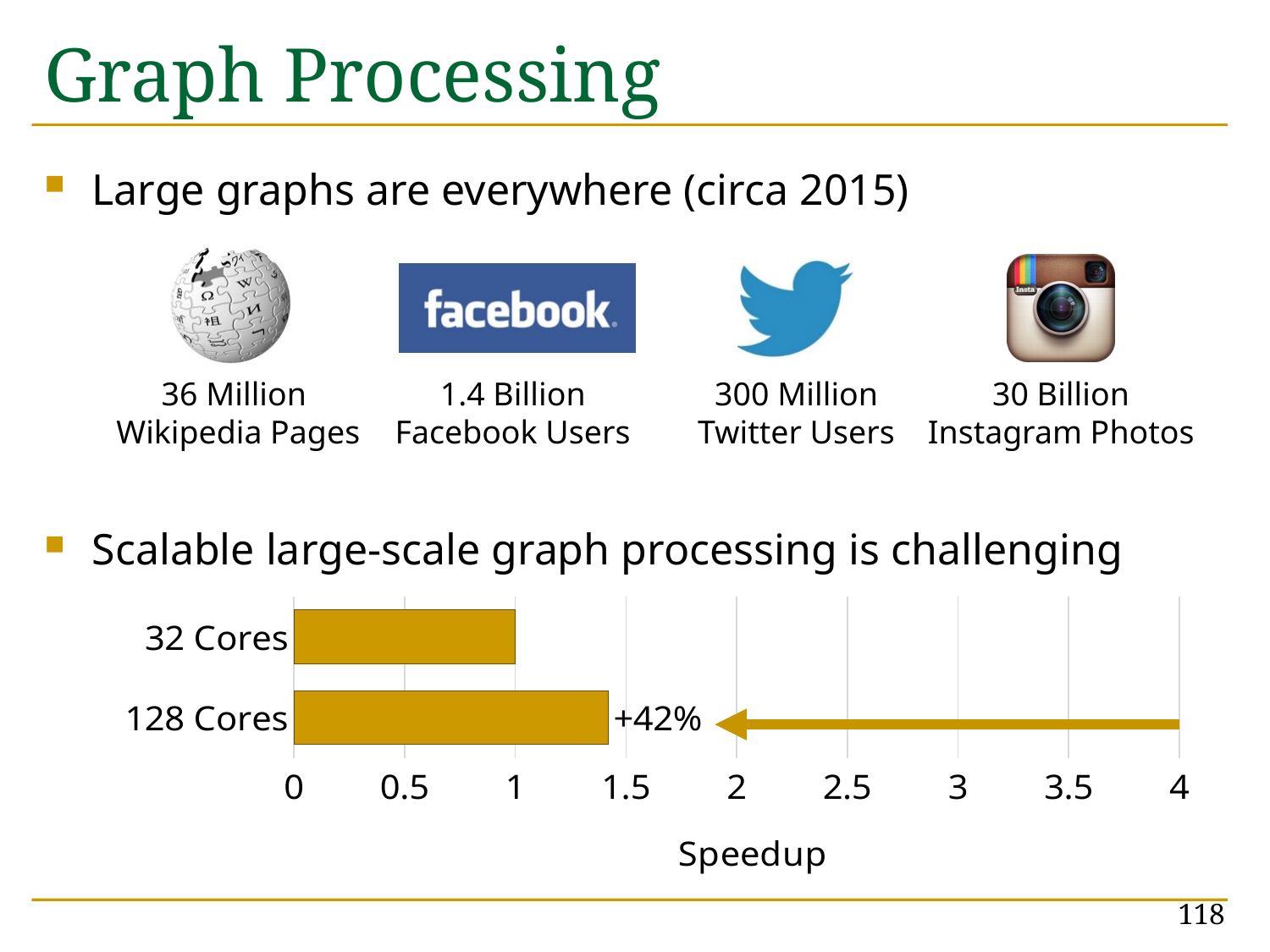
What annotation is printed next to the 128 Cores bar? +42% Is the speedup for 128 Cores greater or less than 1? greater Which has a larger speedup, 32 Cores or 128 Cores? 128 Cores Is the speedup for 32 Cores greater or less than 2? less What kind of chart is shown on the slide? bar chart Which category has the lowest speedup in the chart? 32 Cores What is the speedup value for 32 Cores? 1 Which category has the highest speedup in the chart? 128 Cores Is the speedup for 128 Cores greater or less than 1.5? less What is the label of the x axis in the chart? Speedup How many categories are plotted in the chart? 2